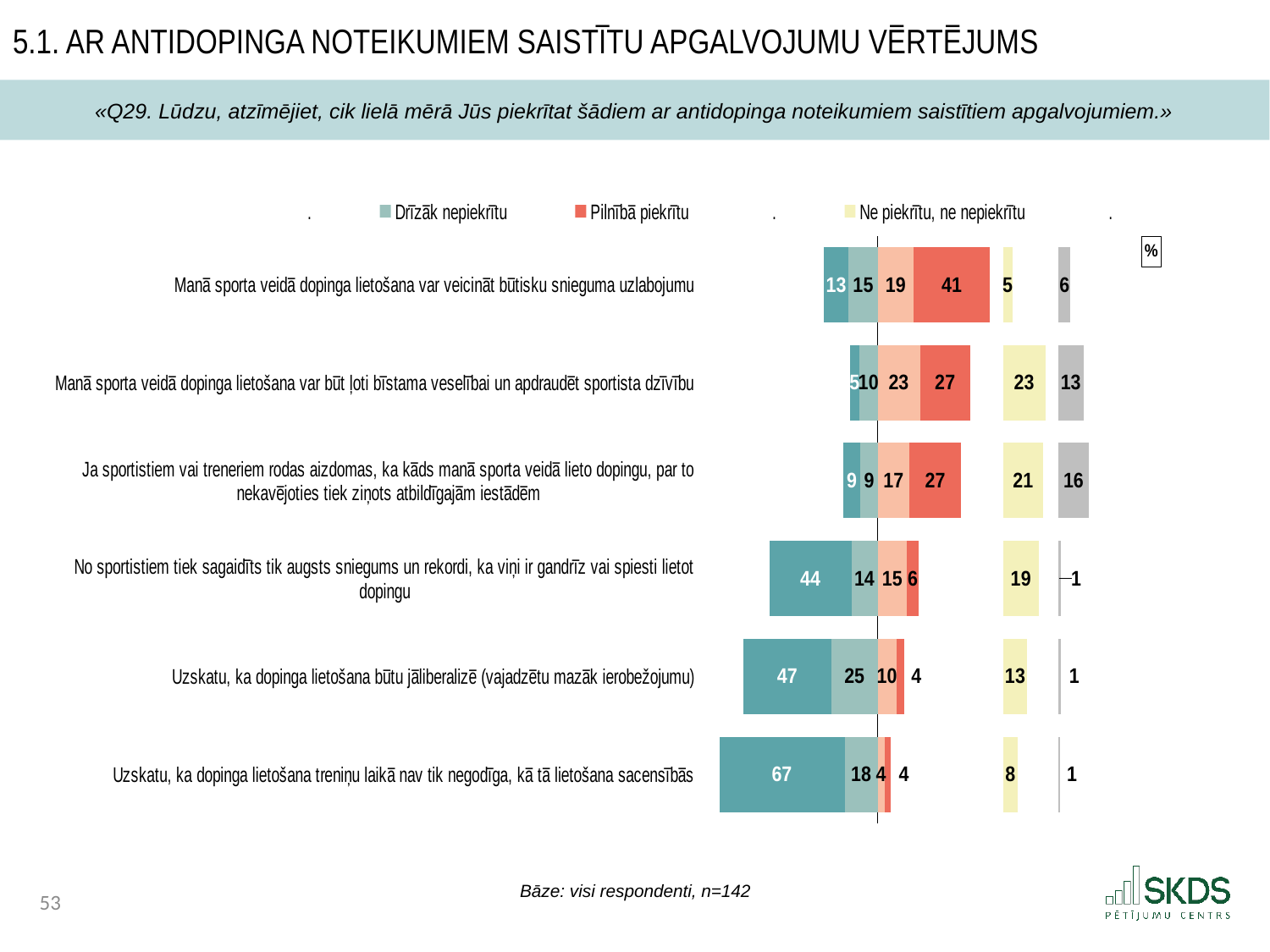
How many statements are shown in the chart? 6 What is the "Pilnībā piekrītu" value for the statement "Uzskatu, ka dopinga lietošana treniņu laikā nav tik negodīga, kā tā lietošana sacensībās"? 4 What is the "Drīzāk nepiekrītu" value for the statement "Uzskatu, ka dopinga lietošana būtu jāliberalizē (vajadzētu mazāk ierobežojumu)"? 25 What is the base (number of respondents) stated below the chart? n=142 What kind of chart is shown on the slide? Stacked bar chart What is the "Drīzāk nepiekrītu" value for the statement "Uzskatu, ka dopinga lietošana treniņu laikā nav tik negodīga, kā tā lietošana sacensībās"? 18 What is the "Ne piekrītu, ne nepiekrītu" value for the statement "Manā sporta veidā dopinga lietošana var būt ļoti bīstama veselībai un apdraudēt sportista dzīvību"? 23 Which statement has the highest "Pilnībā piekrītu" value? Manā sporta veidā dopinga lietošana var veicināt būtisku snieguma uzlabojumu Which is larger: the "Ne piekrītu, ne nepiekrītu" value for "Ja sportistiem vai treneriem rodas aizdomas, ka kāds manā sporta veidā lieto dopingu, par to nekavējoties tiek ziņots atbildīgajām iestādēm" or for "No sportistiem tiek sagaidīts tik augsts sniegums un rekordi, ka viņi ir gandrīz vai spiesti lietot dopingu"? Ja sportistiem vai treneriem rodas aizdomas, ka kāds manā sporta veidā lieto dopingu, par to nekavējoties tiek ziņots atbildīgajām iestādēm What is the difference between the "Pilnībā piekrītu" values for "Manā sporta veidā dopinga lietošana var veicināt būtisku snieguma uzlabojumu" and "Manā sporta veidā dopinga lietošana var būt ļoti bīstama veselībai un apdraudēt sportista dzīvību"? 14 Which statement has the lowest "Ne piekrītu, ne nepiekrītu" value? Uzskatu, ka dopinga lietošana treniņu laikā nav tik negodīga, kā tā lietošana sacensībās What is the "Pilnībā piekrītu" value for the statement "Manā sporta veidā dopinga lietošana var veicināt būtisku snieguma uzlabojumu"? 41